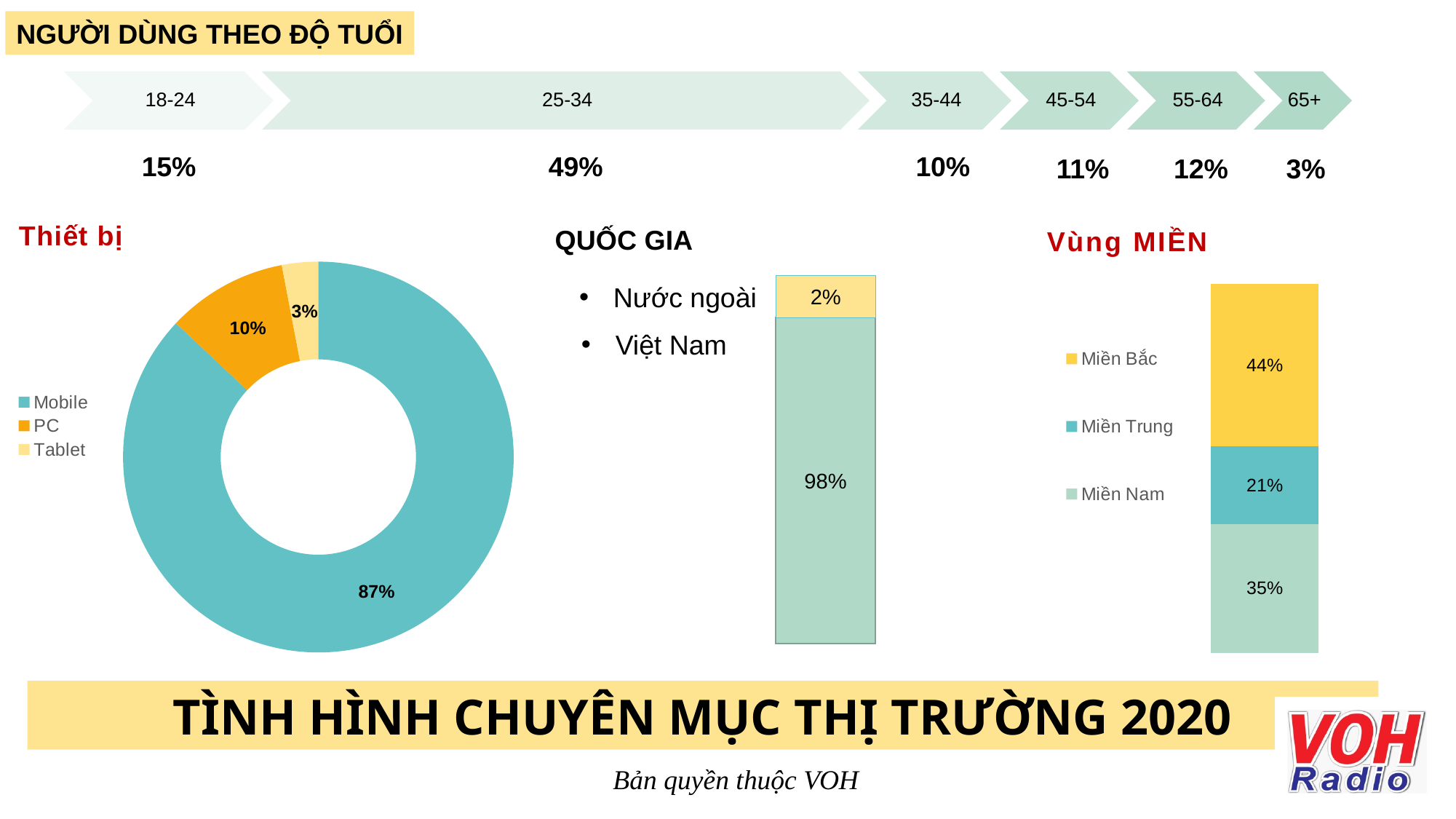
In the "Thiết bị" chart, which device has the smallest share? Tablet In the "Vùng MIỀN" chart, what is the value for Miền Trung? 21% In the "Vùng MIỀN" chart, which is larger, Miền Nam or Miền Trung? Miền Nam How many categories does the "Thiết bị" chart legend list? 3 What kind of chart is the "Thiết bị" chart? Donut (pie) chart In the "Thiết bị" chart, what share does Mobile have? 87% In the "Thiết bị" chart, what is the difference between the Mobile and PC shares? 77% In the "Vùng MIỀN" chart, what is the difference between Miền Bắc and Miền Nam? 9% In the "Thiết bị" chart, what share does PC have? 10% In the "Vùng MIỀN" chart, which region has the largest share? Miền Bắc